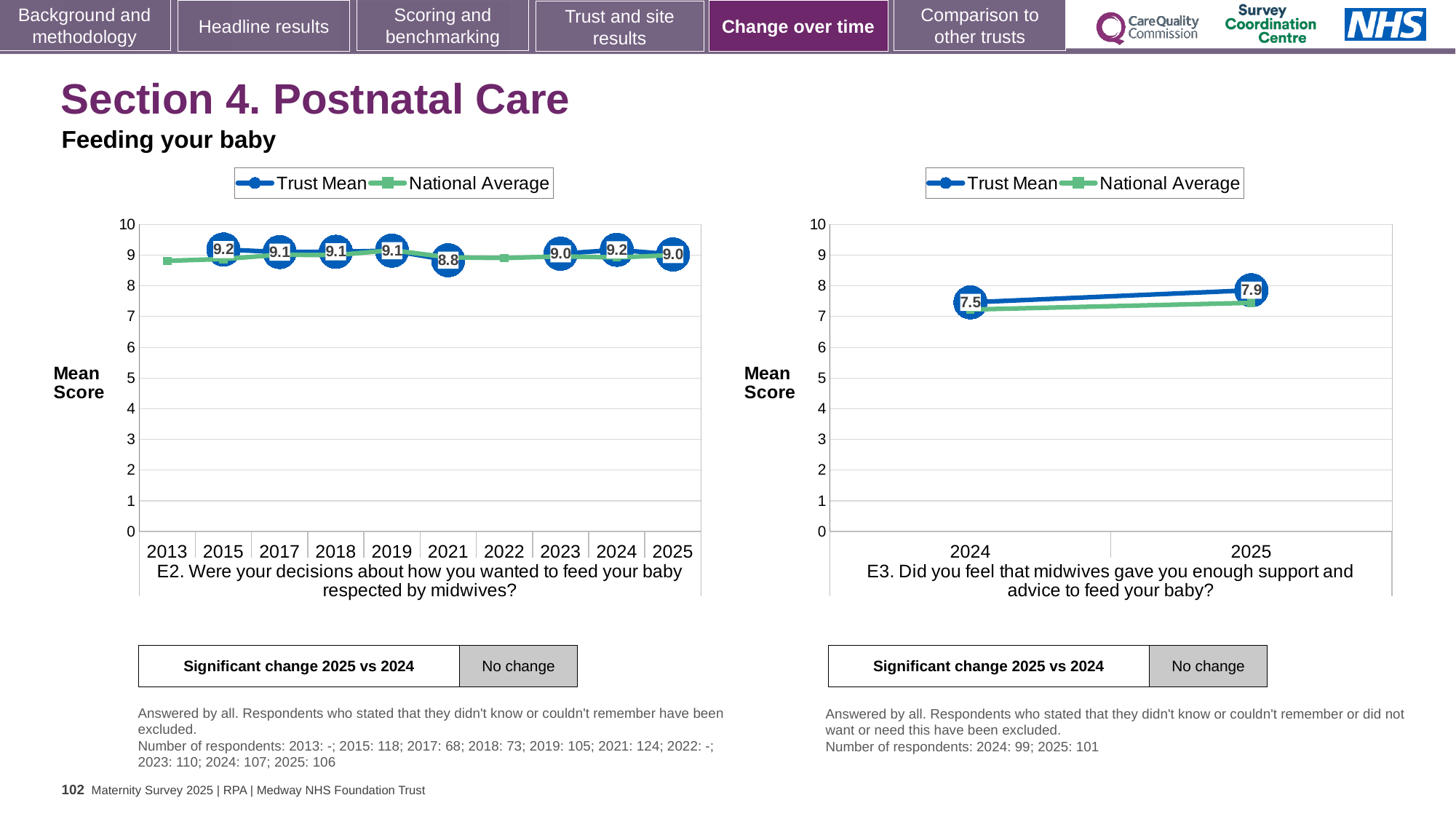
In the left chart (E2), what is the Trust Mean for 2021? 8.8 In the left chart (E2), which is larger, the Trust Mean for 2015 or for 2021? 2015 In the left chart (E2), which year has the lowest labelled Trust Mean? 2021 In the left chart (E2), what is the Trust Mean for 2025? 9.0 In the right chart (E3), by how much did the Trust Mean change from 2024 to 2025? 0.4 In the left chart (E2), how many years are shown on the x axis? 10 In the right chart (E3), does the Trust Mean rise or fall from 2024 to 2025? rise How many series does the legend of the right chart (E3) list? 2 In the right chart (E3), what is the Trust Mean for 2024? 7.5 In the left chart (E2), what is the difference between the Trust Mean for 2024 and for 2025? 0.2 In the left chart (E2), is the National Average for 2013 greater or less than 8? greater In the right chart (E3), what is the Trust Mean for 2025? 7.9